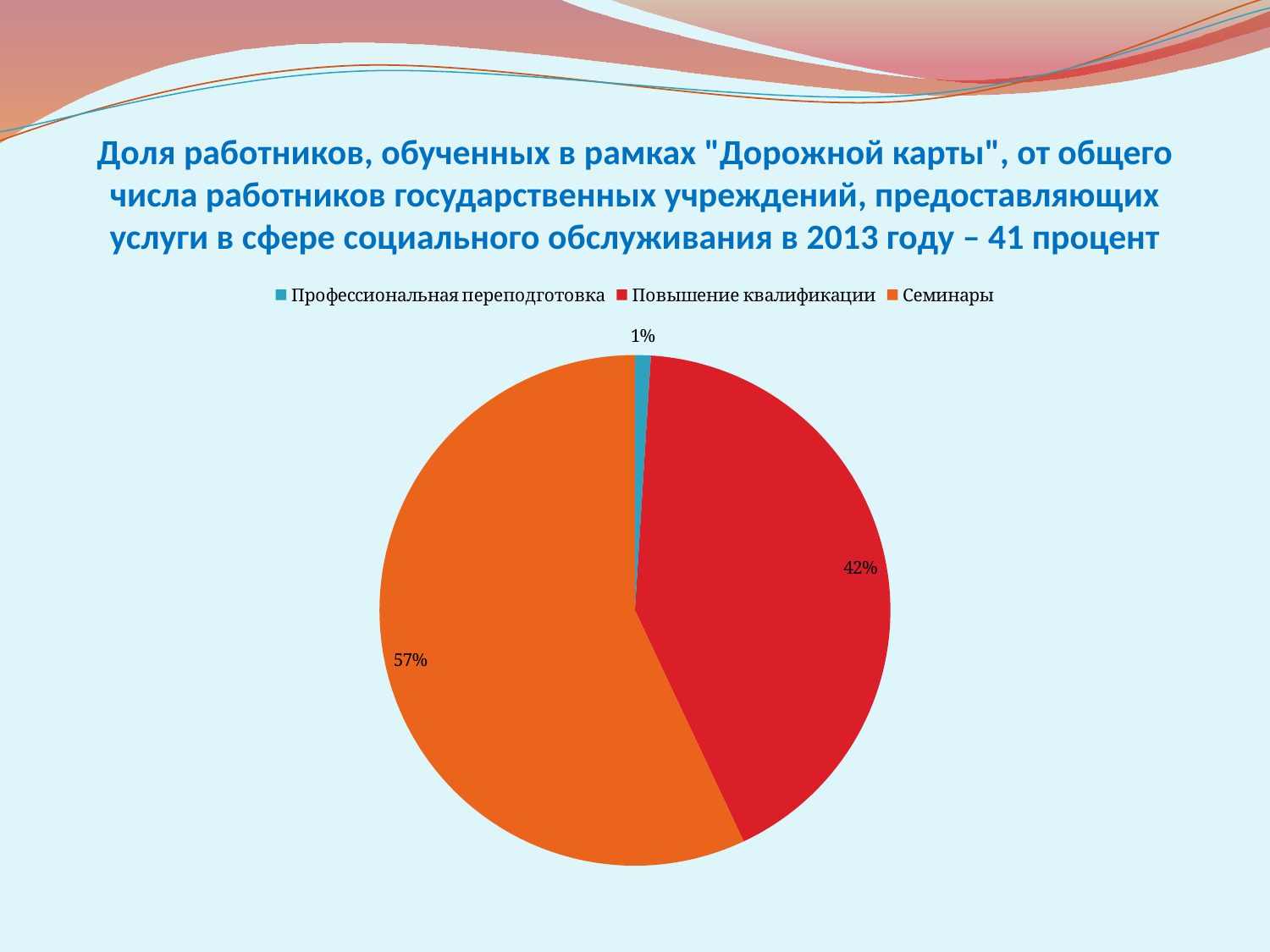
How many categories does the pie chart have? 3 Which category has the smallest slice of the pie? Профессиональная переподготовка What is the difference between the shares of Семинары and Повышение квалификации? 15% What share of the pie does Семинары represent? 57% Which category has the largest slice of the pie? Семинары What share of the pie does Повышение квалификации represent? 42% What share of the pie does Профессиональная переподготовка represent? 1% Which is larger: the share of Семинары or the share of Повышение квалификации? Семинары How many entries does the legend list? 3 What is the difference between the shares of Повышение квалификации and Профессиональная переподготовка? 41% What colour is the slice for Повышение квалификации? red What kind of chart is shown on the slide? pie chart